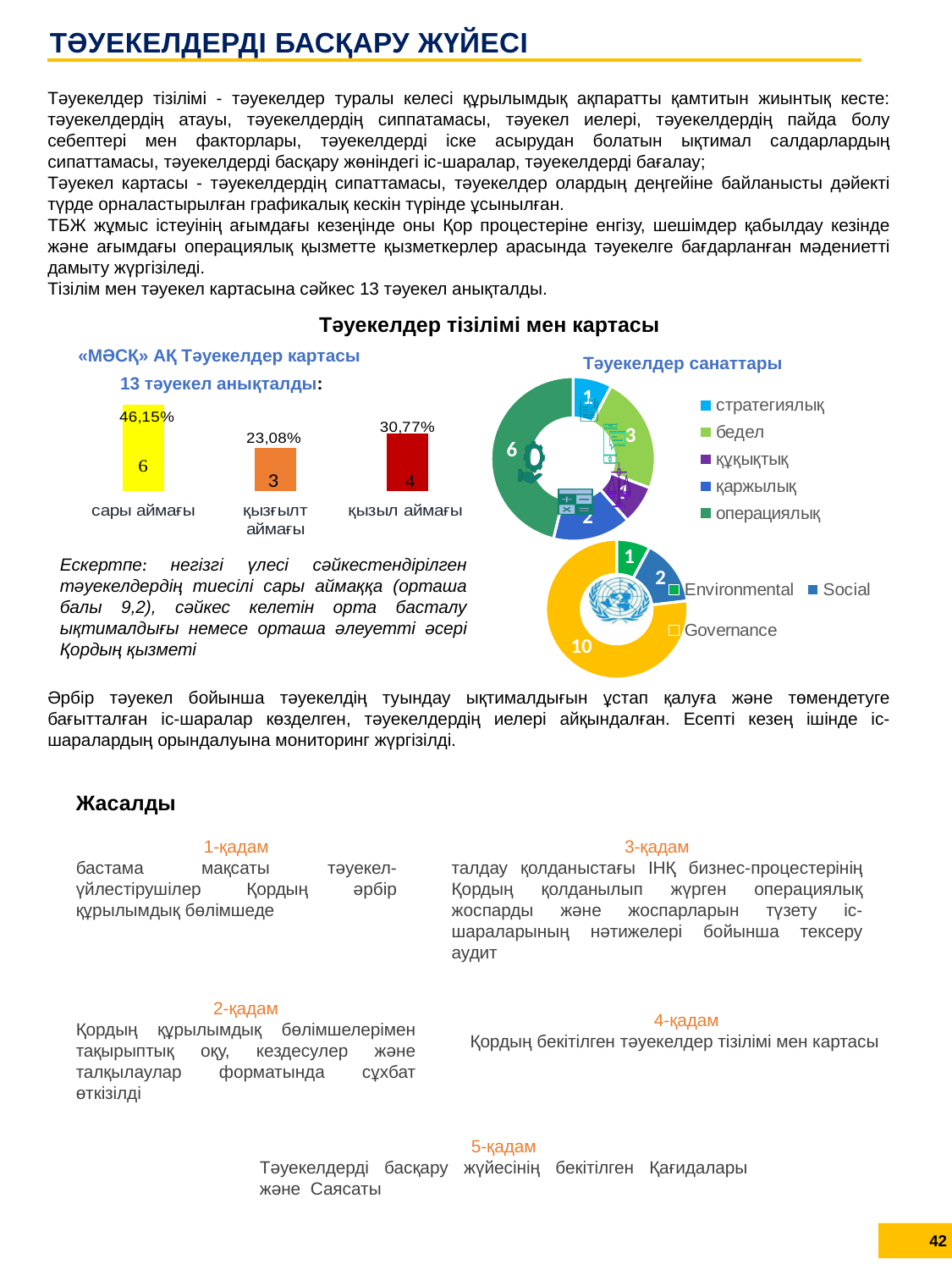
In the Тәуекелдер санаттары donut chart, how many risks are бедел? 3 In the bar chart «МӘСҚ» АҚ Тәуекелдер картасы, how many categories are shown? 3 In the bar chart «МӘСҚ» АҚ Тәуекелдер картасы, what percentage is shown for қызыл аймағы? 30,77% In the bar chart «МӘСҚ» АҚ Тәуекелдер картасы, which category has the highest value? сары аймағы How many categories does the legend of the Тәуекелдер санаттары donut chart list? 5 In the bar chart «МӘСҚ» АҚ Тәуекелдер картасы, how many risks are in the сары аймағы category? 6 In the bar chart «МӘСҚ» АҚ Тәуекелдер картасы, what percentage is shown for қызғылт аймағы? 23,08% In the Тәуекелдер санаттары donut chart, how many risks are операциялық? 6 In the bar chart «МӘСҚ» АҚ Тәуекелдер картасы, what is the difference in the number of risks between сары аймағы and қызыл аймағы? 2 In the lower donut chart with the Environmental, Social and Governance legend, what is the value for Governance? 10 In the bar chart «МӘСҚ» АҚ Тәуекелдер картасы, which category has the lowest value? қызғылт аймағы What type of chart is «МӘСҚ» АҚ Тәуекелдер картасы? bar chart